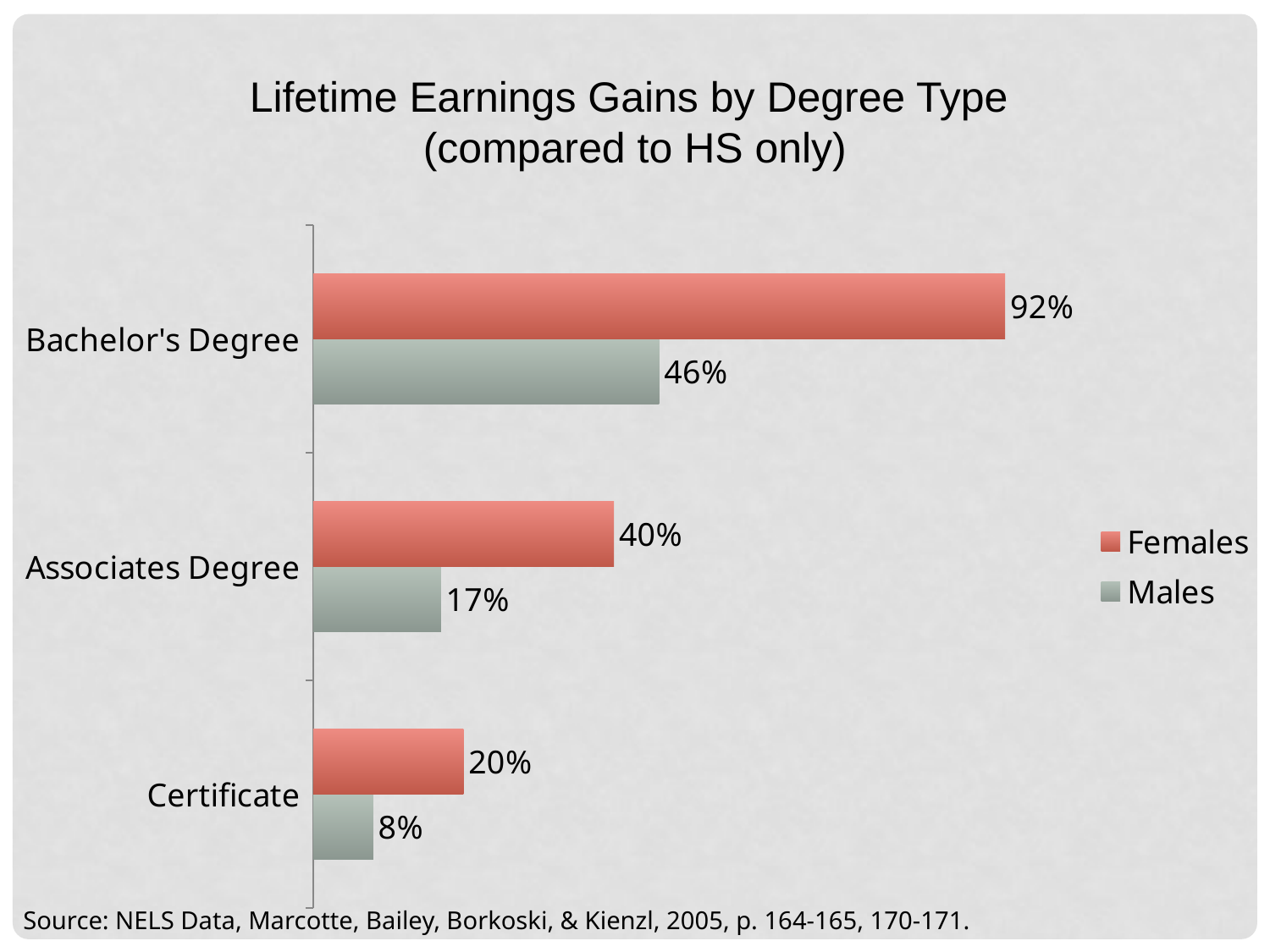
What is the difference between the Females and Males earnings gains for a Bachelor's Degree? 46% Which is larger: the Females gain for a Certificate or the Males gain for an Associates Degree? Females gain for a Certificate What is the lifetime earnings gain for Males with an Associates Degree? 17% What is the title of the chart? Lifetime Earnings Gains by Degree Type (compared to HS only) What is the difference between the Females and Males earnings gains for an Associates Degree? 23% Which degree type has the highest earnings gain for Females? Bachelor's Degree How many degree types are shown on the chart? 3 What is the lifetime earnings gain for Males with a Certificate? 8% What is the lifetime earnings gain for Females with a Bachelor's Degree? 92% What kind of chart is shown on the slide? Bar chart How many series does the legend list? 2 Which degree type has the lowest earnings gain for Males? Certificate